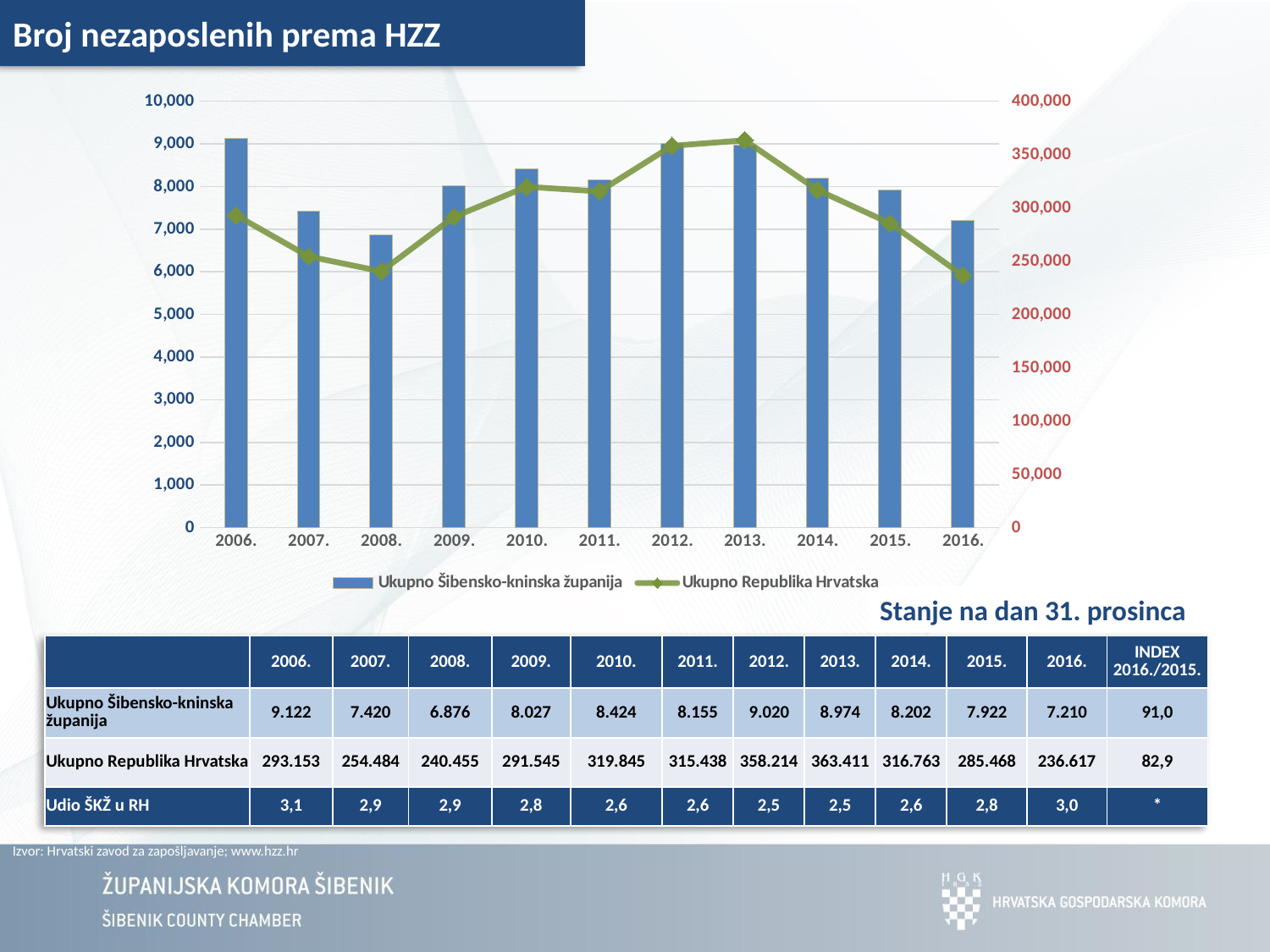
How many series does the chart legend list? 2 What is the value for Ukupno Republika Hrvatska in 2013? 363.411 Which series is drawn as bars in the chart? Ukupno Šibensko-kninska županija Which is larger for Ukupno Šibensko-kninska županija: the value in 2009 or in 2011? 2011. What kind of chart is shown on the slide? A bar chart combined with a line chart What is the title of the slide's chart? Broj nezaposlenih prema HZZ In which year is the bar for Ukupno Šibensko-kninska županija the lowest? 2008. How many years are shown on the x axis of the chart? 11 Is the bar for Ukupno Šibensko-kninska županija in 2008 greater or less than 7,000? less In which year is the line for Ukupno Republika Hrvatska at its lowest? 2016. In which year is the bar for Ukupno Šibensko-kninska županija the highest? 2006. What is the value for Ukupno Šibensko-kninska županija in 2010? 8.424